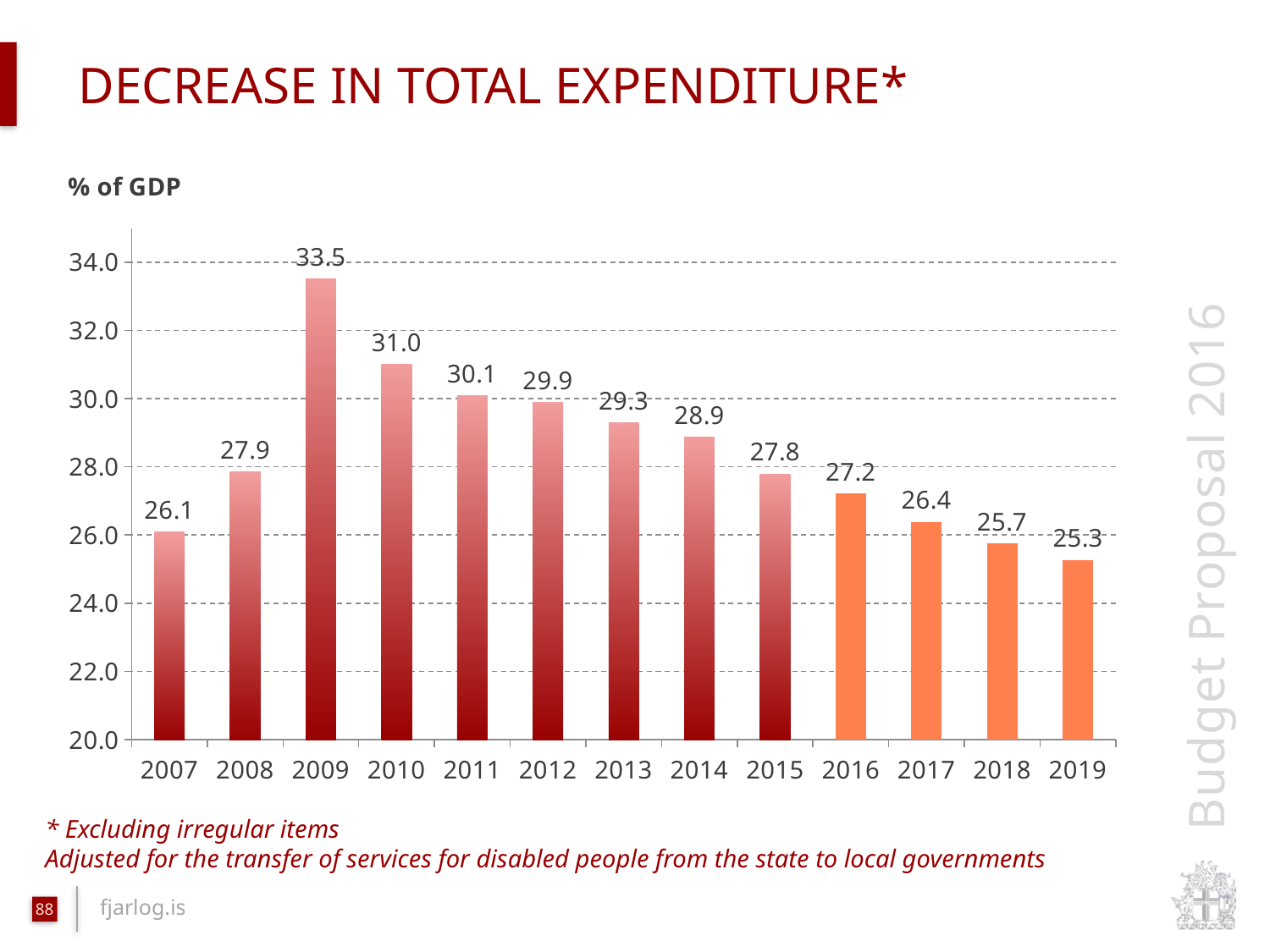
Which year has the highest value? 2009 What is the title of the chart? DECREASE IN TOTAL EXPENDITURE* Which year has the lowest value? 2019 What is the value for 2009? 33.5 Which is larger, the value for 2007 or the value for 2015? 2015 What is the difference between the values for 2009 and 2019? 8.2 What is the value for 2016? 27.2 What kind of chart is shown on the slide? bar chart What is the value for 2019? 25.3 How many years are shown on the x axis? 13 Is the value for 2010 greater or less than 30.0? greater Do the values rise or fall from 2009 to 2019? fall